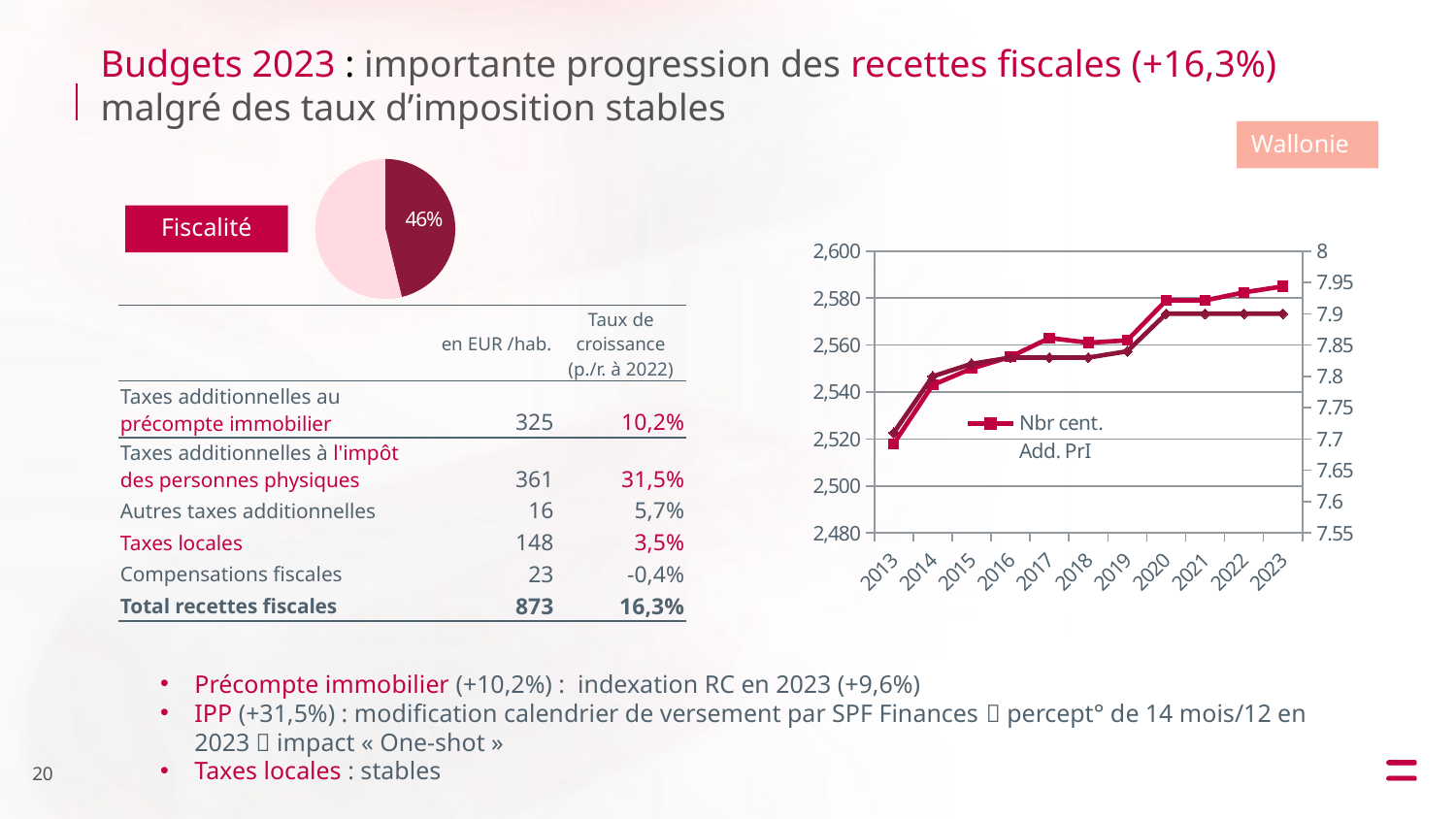
In the line chart, is the 'Nbr cent.' value for 2017 greater or less than 2,560 on the left axis? greater What is the highest tick value on the left axis of the line chart? 2,600 What kind of chart is the chart on the right side of the slide? line chart How many years are shown on the x axis of the line chart? 11 How many slices does the pie chart next to 'Fiscalité' have? 2 In the pie chart next to 'Fiscalité', what share is shown by the labelled slice? 46% In the line chart, is the 'Nbr cent.' value for 2023 greater or less than 2,580 on the left axis? greater In the line chart, do the values generally rise or fall from 2013 to 2023? rise What is the first year shown on the x axis of the line chart? 2013 What kind of chart is shown next to the 'Fiscalité' label? pie chart In the line chart, which year has the higher 'Nbr cent.' value, 2013 or 2023? 2023